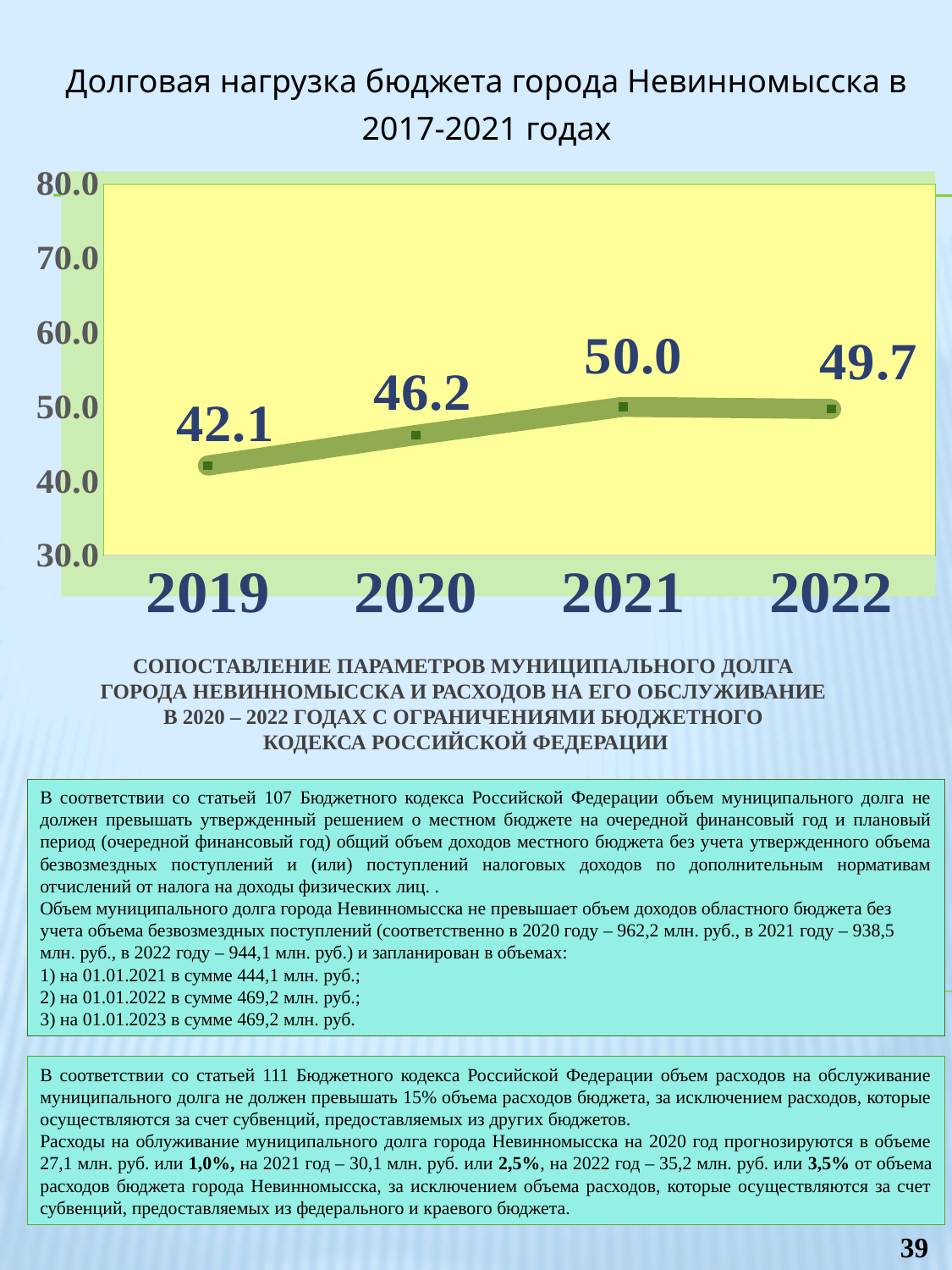
What kind of chart is shown on the slide? Line chart Which year has the lowest value? 2019 What is the value for 2020? 46.2 Which year has the highest value? 2021 Which is larger, the value for 2020 or the value for 2022? 2022 What is the value for 2021? 50.0 What is the difference between the values for 2020 and 2019? 4.1 How many years are plotted on the chart? 4 What is the value for 2019? 42.1 What is the difference between the values for 2021 and 2019? 7.9 What is the value for 2022? 49.7 Does the value rise or fall from 2019 to 2021? Rise